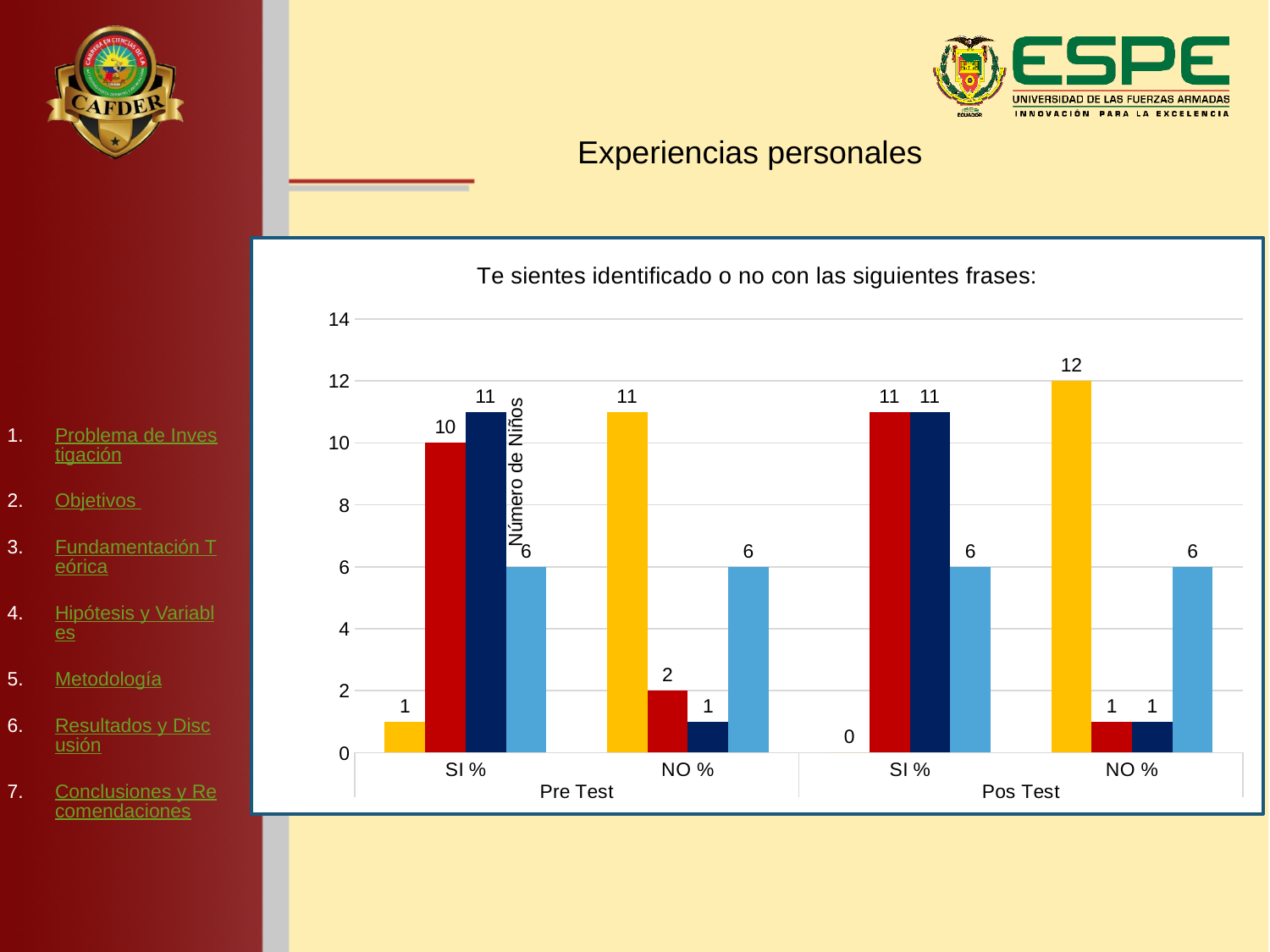
What kind of chart is shown on the slide? bar chart What is the value of the light blue bar for SI % in the Pre Test group? 6 What is the label of the vertical axis? Número de Niños Which bar has the highest value in the whole chart? the yellow bar for NO % in Pos Test (12) Which is larger: the red bar for SI % in Pre Test or the red bar for SI % in Pos Test? Pos Test (11) How many bars are shown for each SI %/NO % category? 4 What is the value of the yellow bar for NO % in the Pos Test group? 12 What is the title of the chart? Te sientes identificado o no con las siguientes frases: What is the value of the yellow bar for SI % in the Pos Test group? 0 What is the value of the red bar for SI % in the Pre Test group? 10 What is the difference between the yellow bar for NO % in Pos Test and the yellow bar for NO % in Pre Test? 1 What is the value of the red bar for NO % in the Pre Test group? 2